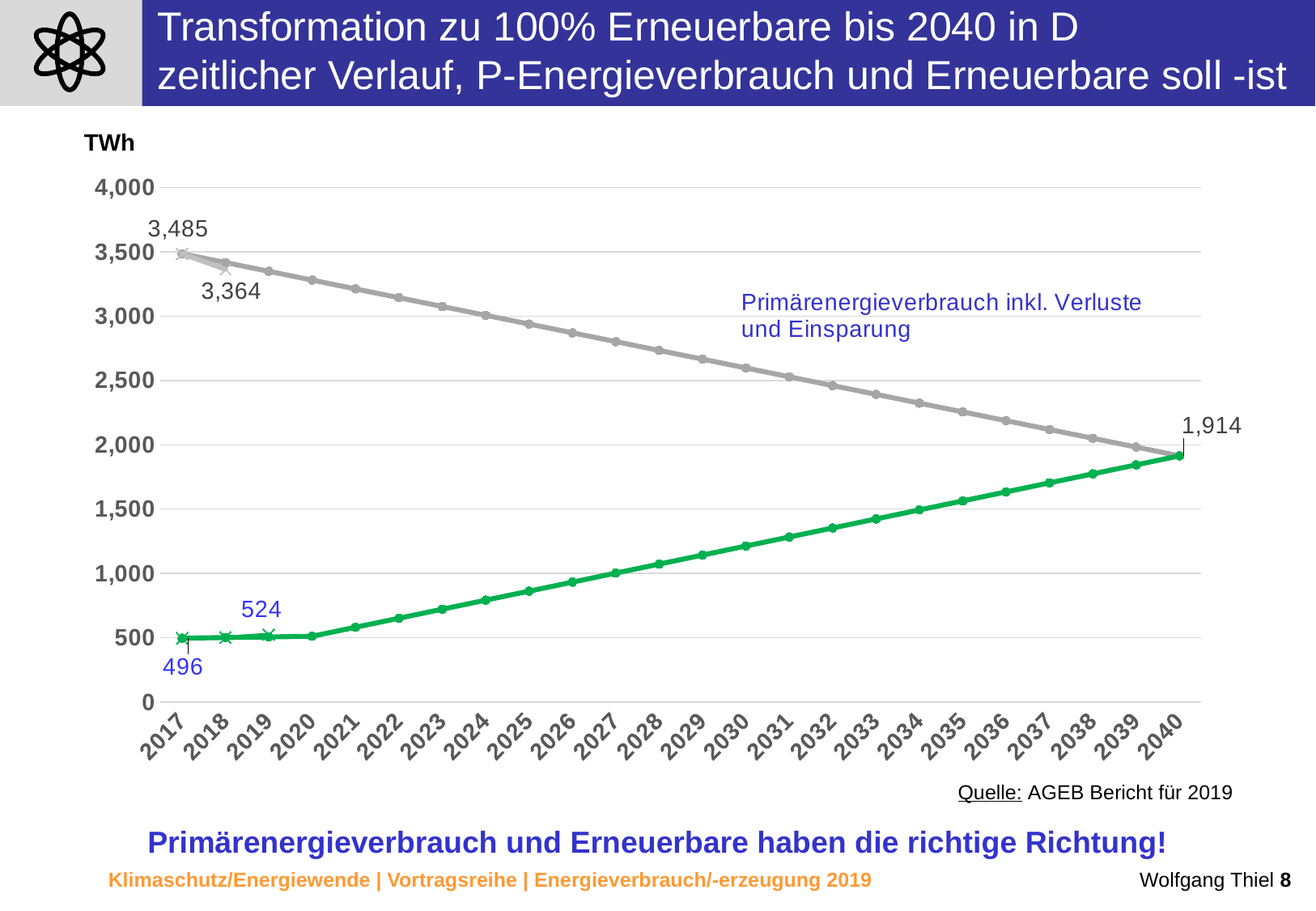
How many years are shown on the x axis? 24 What is the difference between the grey line and the green line in 2017? 2,989 By how much does the grey Primärenergieverbrauch line fall from 2017 to 2040? 1,571 Does the grey Primärenergieverbrauch line rise or fall from 2017 to 2040? Fall What is the value of the grey Primärenergieverbrauch line in 2017? 3,485 Is the value of the green line in 2025 greater or less than 1,000? less What type of chart is shown on the slide? Line chart What value is labelled at the 2019 point of the green line? 524 Is the value of the grey line in 2030 greater or less than 2,500? greater What value do both lines reach in 2040? 1,914 What is the value of the green Erneuerbare line in 2017? 496 What value is labelled at the 2018 point of the grey line? 3,364